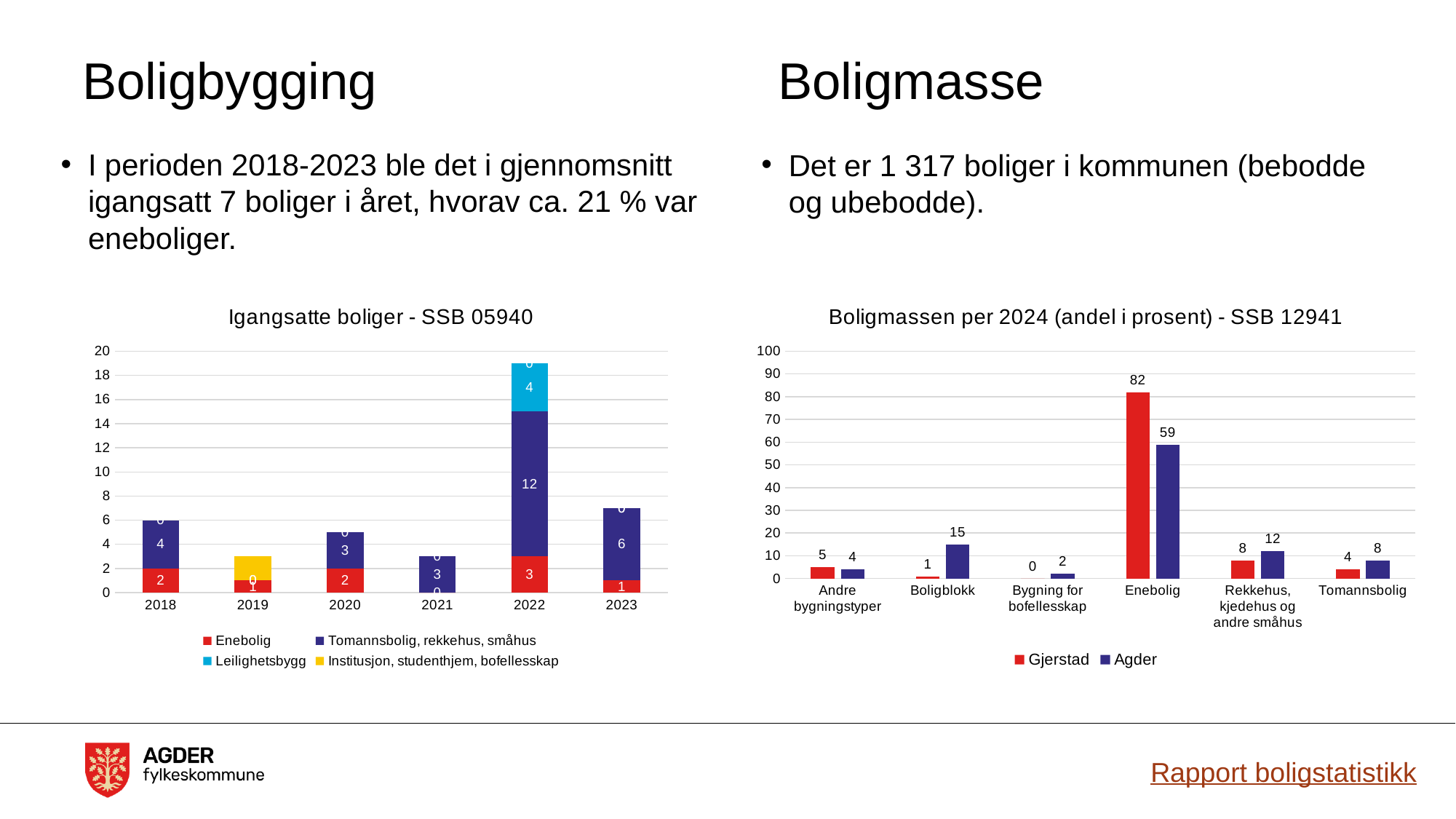
In the 'Boligmassen per 2024 (andel i prosent) - SSB 12941' chart, what is the value for Gjerstad for Enebolig? 82 In the 'Igangsatte boliger - SSB 05940' chart, what is the value for Tomannsbolig, rekkehus, småhus in 2022? 12 In the 'Igangsatte boliger - SSB 05940' chart, which year has the highest stacked bar? 2022 In the 'Boligmassen per 2024 (andel i prosent) - SSB 12941' chart, which category has the lowest value for Gjerstad? Bygning for bofellesskap In the 'Igangsatte boliger - SSB 05940' chart, how many years are shown on the x axis? 6 In the 'Boligmassen per 2024 (andel i prosent) - SSB 12941' chart, what is the value for Agder for Boligblokk? 15 In the 'Boligmassen per 2024 (andel i prosent) - SSB 12941' chart, which is larger for Rekkehus, kjedehus og andre småhus: Gjerstad or Agder? Agder What kind of chart is 'Boligmassen per 2024 (andel i prosent) - SSB 12941'? Bar chart In the 'Igangsatte boliger - SSB 05940' chart, what is the total of the stacked bar for 2022? 19 In the 'Igangsatte boliger - SSB 05940' chart, how many series does the legend list? 4 In the 'Boligmassen per 2024 (andel i prosent) - SSB 12941' chart, what is the difference between Gjerstad and Agder for Enebolig? 23 In the 'Igangsatte boliger - SSB 05940' chart, what is the value for Enebolig in 2018? 2